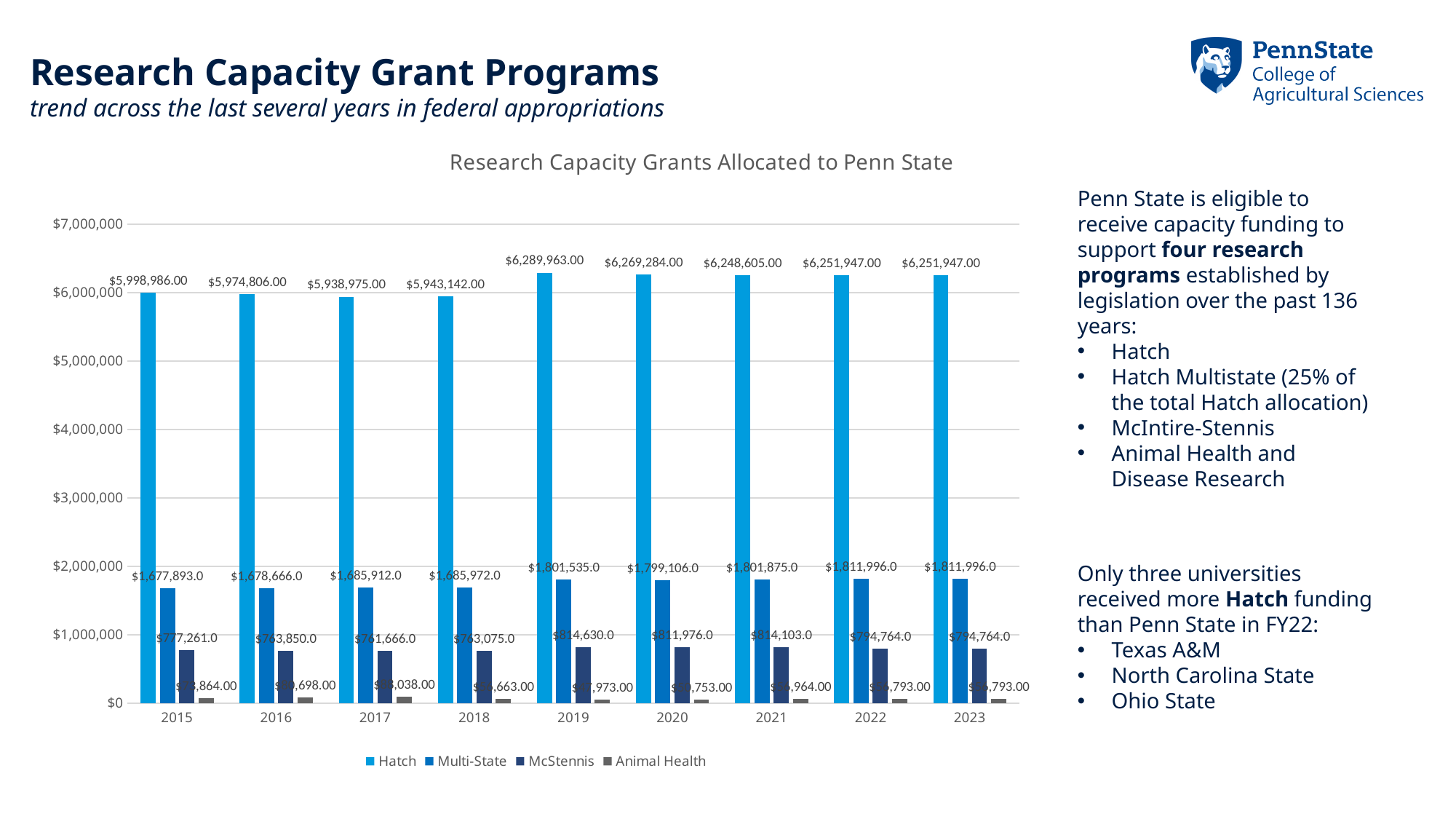
In which year was the Hatch allocation highest? 2019 What is the difference between the McStennis value in 2019 and the McStennis value in 2018? $51,555.0 What is the difference between the Hatch value in 2019 and the Hatch value in 2015? $290,977.00 Which is larger, the Multi-State value for 2019 or for 2020? 2019 What is the McStennis value for 2015? $777,261.0 In which year was the Hatch allocation lowest? 2017 Is the Hatch value for 2015 greater or less than $5,000,000? greater What kind of chart is shown on the slide? bar chart How many series does the legend list? 4 What is the Multi-State value for 2023? $1,811,996.0 What is the Hatch value for 2019? $6,289,963.00 How many years are shown on the x axis? 9